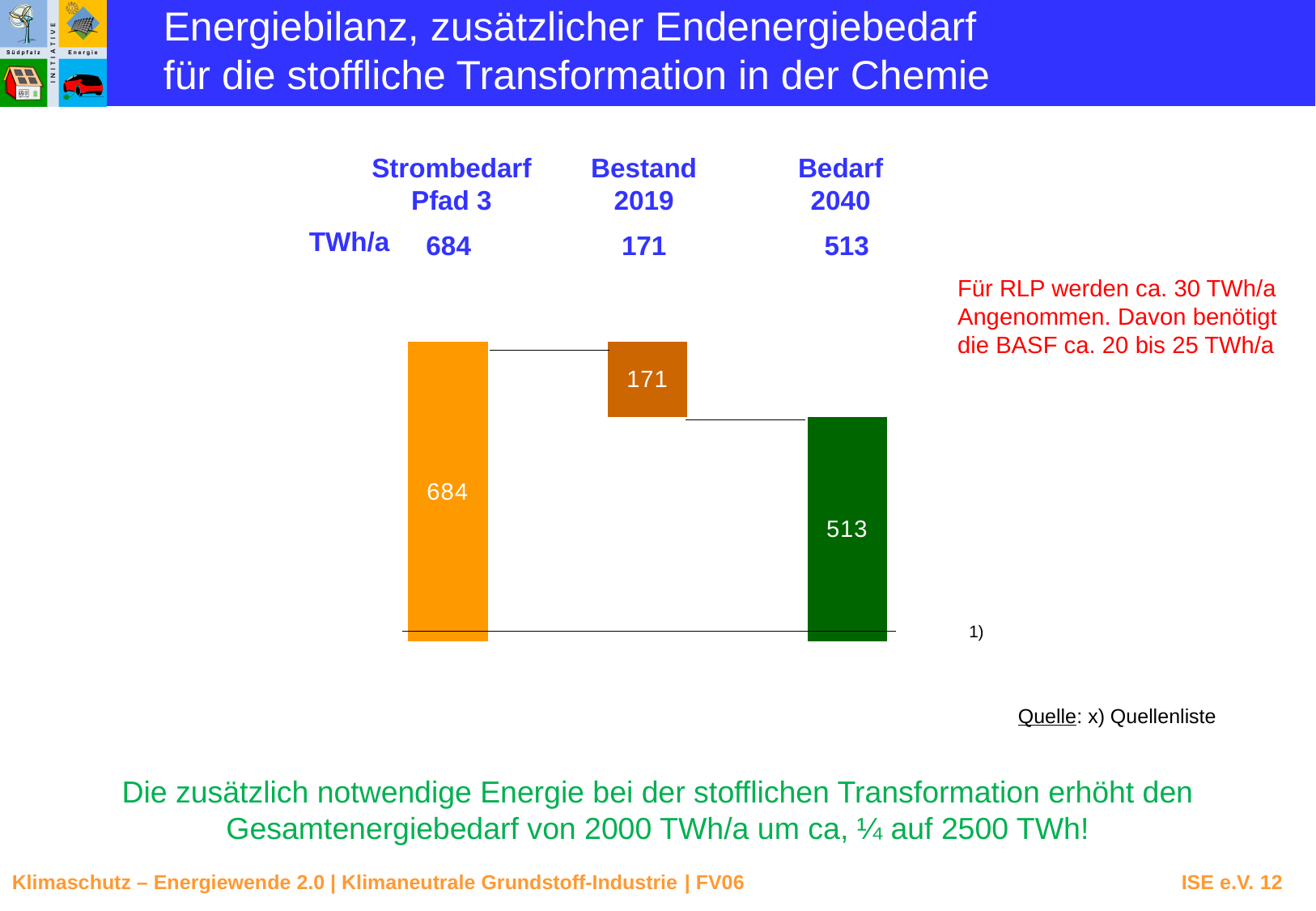
What unit is given for the values in the chart? TWh/a Which is larger, Bedarf 2040 or Bestand 2019? Bedarf 2040 How many bars are shown in the chart? 3 Which category has the lowest value? Bestand 2019 Which category has the highest value? Strombedarf Pfad 3 What colour is the bar for Bedarf 2040? Dark green What is the value shown for Bestand 2019? 171 What is the difference between Strombedarf Pfad 3 and Bedarf 2040? 171 What is the value shown for Bedarf 2040? 513 What is the value shown for Strombedarf Pfad 3? 684 What kind of chart is shown on the slide? Bar chart What is the difference between Bedarf 2040 and Bestand 2019? 342